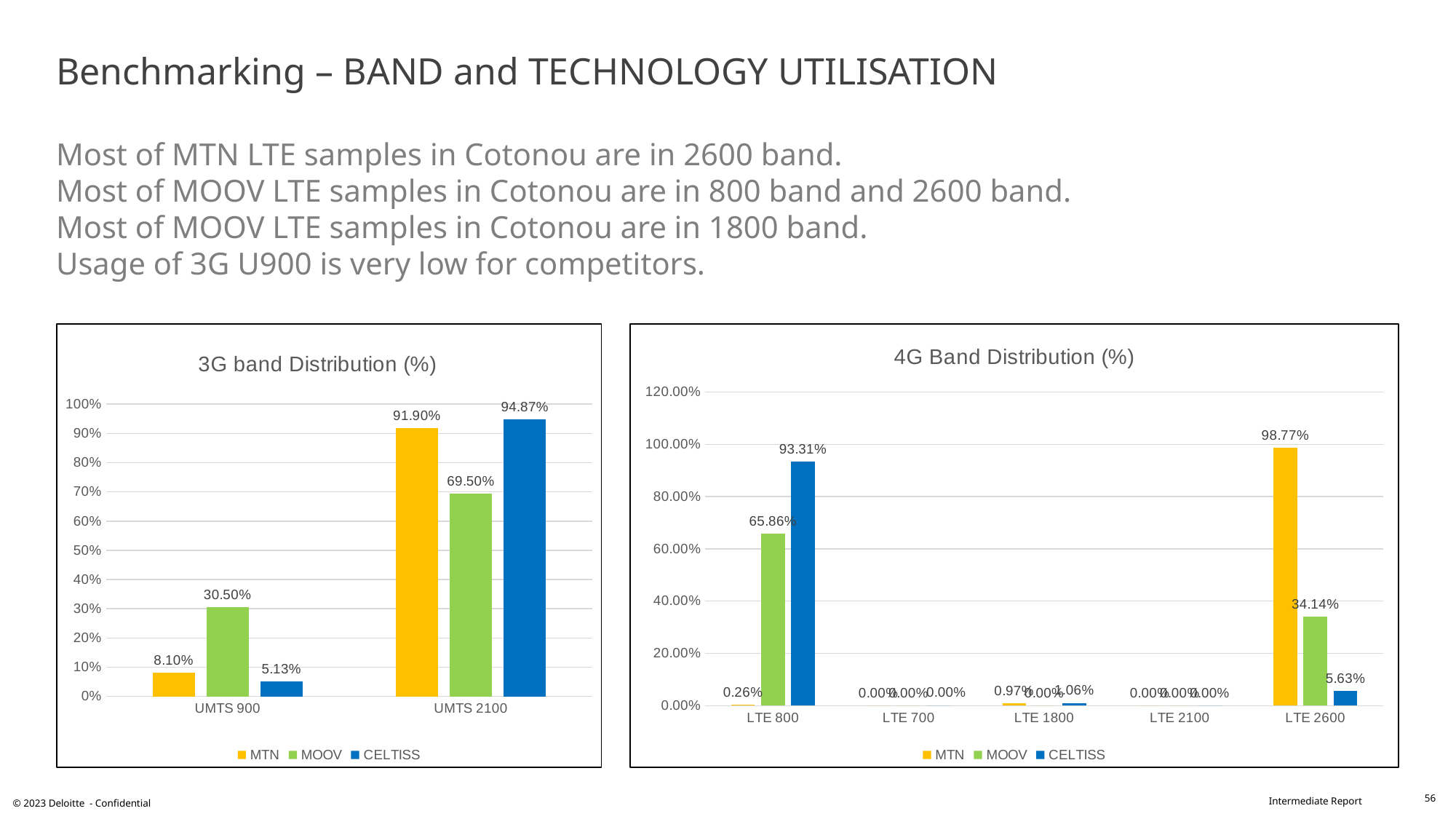
In the 4G Band Distribution (%) chart, how many bands are shown on the x axis? 5 How many series does the legend of the 4G Band Distribution (%) chart list? 3 In the 4G Band Distribution (%) chart, is the MOOV value at LTE 800 larger or the CELTISS value at LTE 800? CELTISS In the 3G band Distribution (%) chart, what is the value for CELTISS at UMTS 2100? 94.87% In the 3G band Distribution (%) chart, what is the difference between the MTN values at UMTS 2100 and UMTS 900? 83.80% In the 4G Band Distribution (%) chart, what is the value for MOOV at LTE 2600? 34.14% In the 3G band Distribution (%) chart, which operator has the highest value at UMTS 2100? CELTISS In the 4G Band Distribution (%) chart, which band has the highest MTN value? LTE 2600 In the 3G band Distribution (%) chart, which operator has the lowest value at UMTS 900? CELTISS What type of chart is the 3G band Distribution (%) chart? Bar chart In the 4G Band Distribution (%) chart, what is the value for CELTISS at LTE 800? 93.31% In the 3G band Distribution (%) chart, what is the value for MOOV at UMTS 900? 30.50%